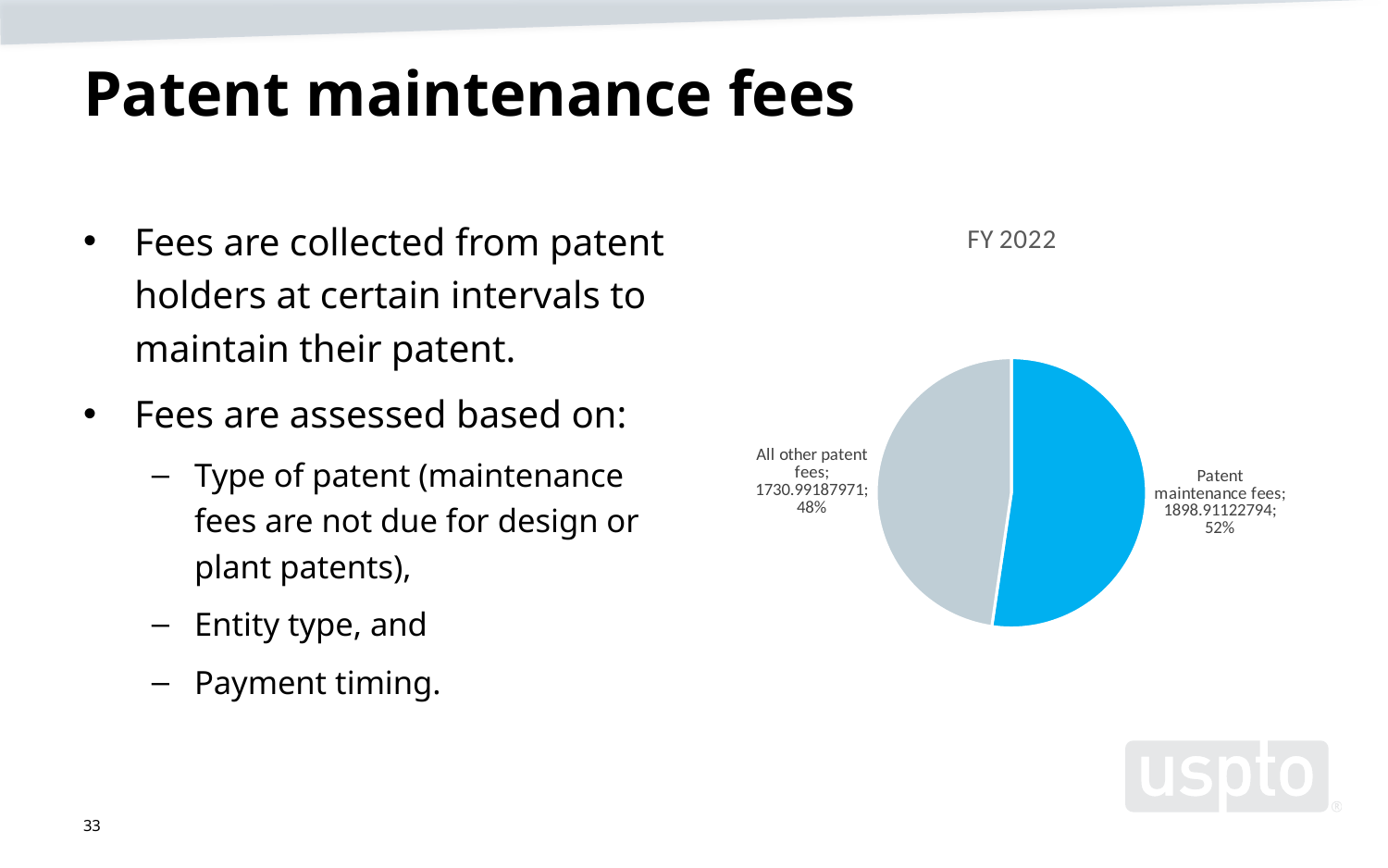
Which slice is the largest? Patent maintenance fees What is the difference between the values for Patent maintenance fees and All other patent fees? 167.91934823 Which is larger, Patent maintenance fees or All other patent fees? Patent maintenance fees What is the value shown for All other patent fees? 1730.99187971 What colour is the Patent maintenance fees slice? blue What is the value shown for Patent maintenance fees? 1898.91122794 What is the title of the chart? FY 2022 What share of the pie is Patent maintenance fees? 52% What share of the pie is All other patent fees? 48% How many slices does the pie chart have? 2 What type of chart is shown on the slide? pie chart Which slice is the smallest? All other patent fees